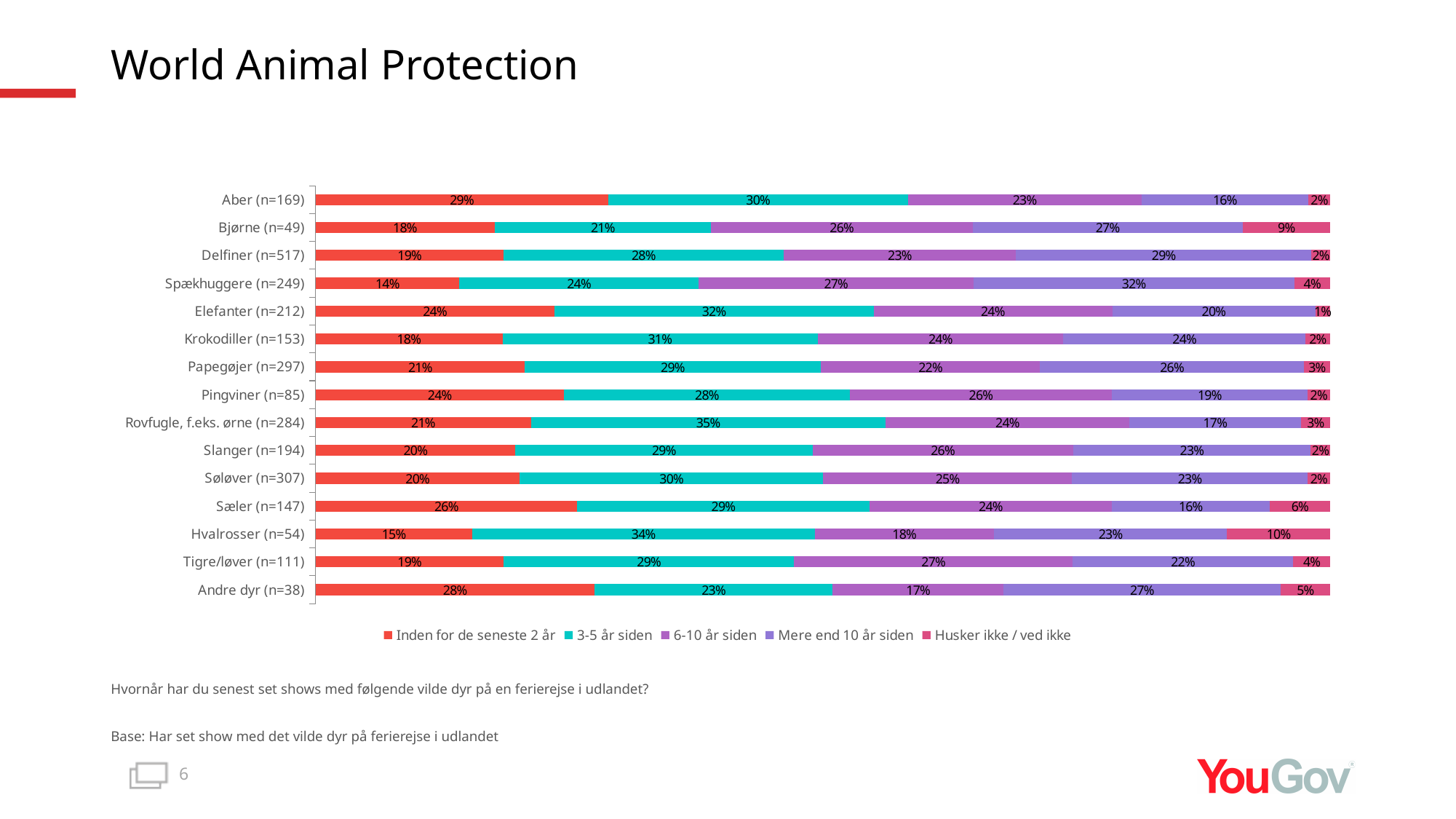
What is the total of the stacked bar for Elefanter (n=212)? 101% Which animal category has the highest 'Inden for de seneste 2 år' share? Aber (n=169) What is the 'Husker ikke / ved ikke' value for Hvalrosser (n=54)? 10% What is the difference between the 'Mere end 10 år siden' values for Spækhuggere (n=249) and Aber (n=169)? 16% Which animal category has the lowest 'Inden for de seneste 2 år' share? Spækhuggere (n=249) How many series does the legend list? 5 What is the '3-5 år siden' value for Rovfugle, f.eks. ørne (n=284)? 35% What percentage of respondents for Aber (n=169) answered 'Inden for de seneste 2 år'? 29% Which legend entry is shown in red? Inden for de seneste 2 år How many animal categories are shown in the chart? 15 What type of chart is shown on the slide? Stacked bar chart Which has a larger '6-10 år siden' value: Bjørne (n=49) or Hvalrosser (n=54)? Bjørne (n=49)